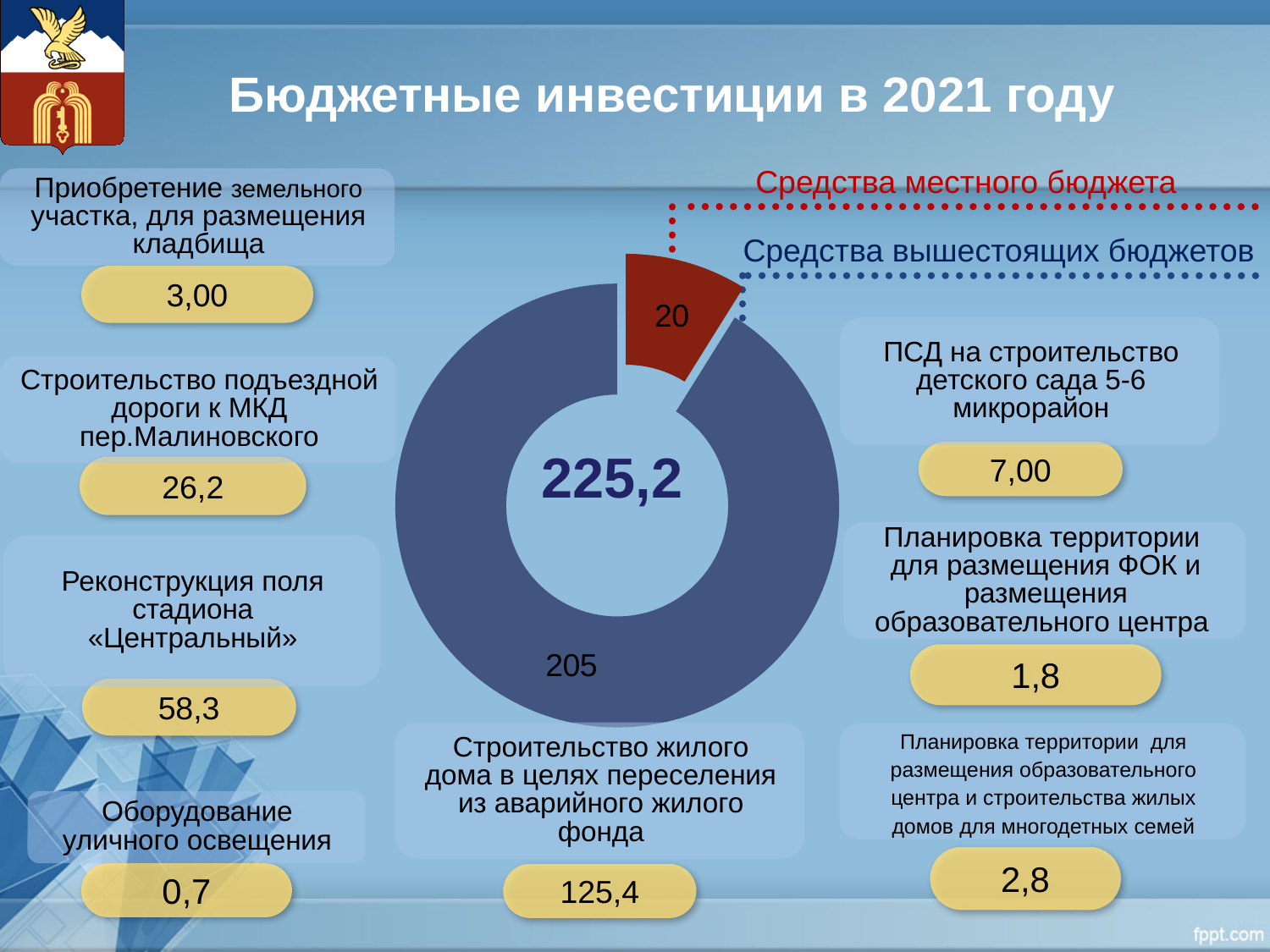
What is the value of the slice labelled «Средства местного бюджета» (the red slice)? 20 How many slices does the donut chart have? 2 What is the title of the slide containing the donut chart? Бюджетные инвестиции в 2021 году Which slice of the donut chart is the smallest? Средства местного бюджета Which slice of the donut chart is the largest? Средства вышестоящих бюджетов What is the value of the slice labelled «Средства вышестоящих бюджетов» (the blue slice)? 205 What total value is printed in the centre of the donut chart? 225,2 Which is larger: the value for «Средства местного бюджета» or the value for «Средства вышестоящих бюджетов»? Средства вышестоящих бюджетов What kind of chart is shown on the slide? Donut (pie) chart What is the difference between the values of the two slices (205 and 20)? 185 What colour is the slice for «Средства местного бюджета»? Red